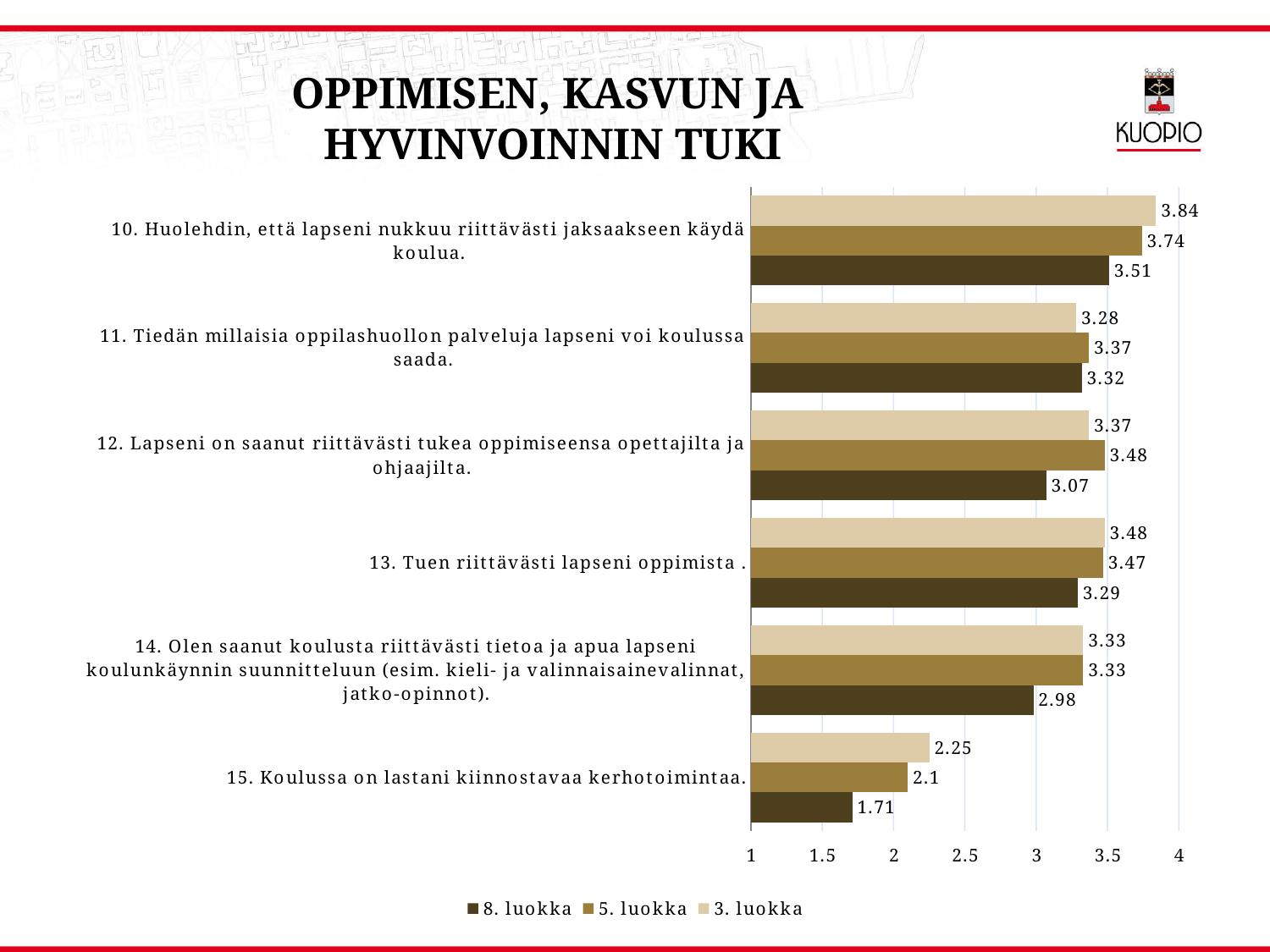
On statement 12, which is larger: the value for 5. luokka or the value for 8. luokka? 5. luokka What is the value for 3. luokka on statement 10 (Huolehdin, että lapseni nukkuu riittävästi jaksaakseen käydä koulua)? 3.84 Which statement has the lowest value for 8. luokka? 15. Koulussa on lastani kiinnostavaa kerhotoimintaa. What kind of chart is shown on the slide? bar chart How many statements (categories) are plotted on the chart? 6 Is the value for 3. luokka on statement 15 greater or less than 2.5? less What is the difference between the 3. luokka and 8. luokka values on statement 14 (Olen saanut koulusta riittävästi tietoa ja apua lapseni koulunkäynnin suunnitteluun)? 0.35 Which statement has the highest value for 3. luokka? 10. Huolehdin, että lapseni nukkuu riittävästi jaksaakseen käydä koulua. How many series does the legend list? 3 Which series is shown with the darkest brown bars? 8. luokka What is the value for 5. luokka on statement 12 (Lapseni on saanut riittävästi tukea oppimiseensa opettajilta ja ohjaajilta)? 3.48 What is the value for 8. luokka on statement 15 (Koulussa on lastani kiinnostavaa kerhotoimintaa)? 1.71